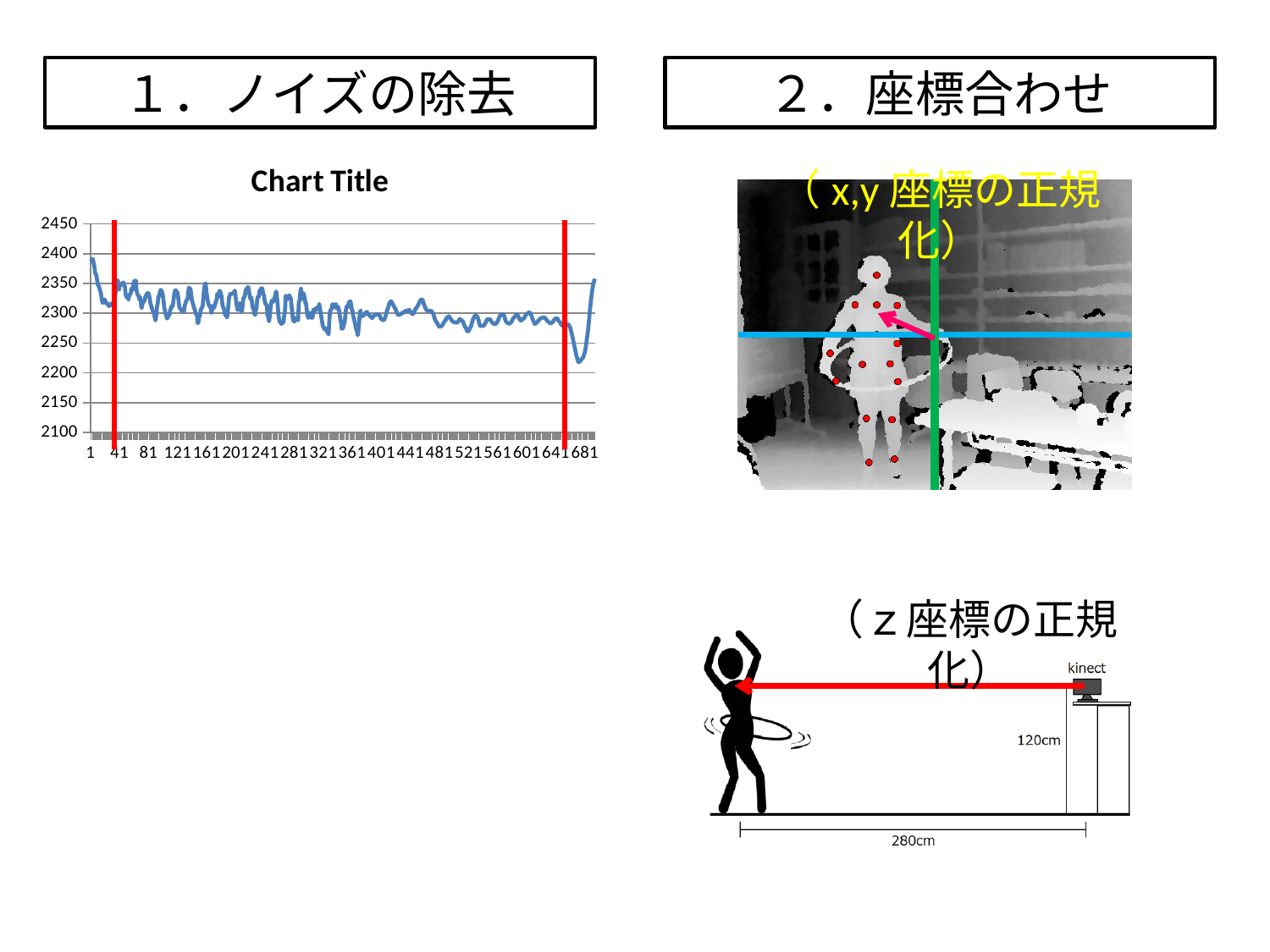
Is the value at x = 41 on the chart greater or less than 2300? greater What is the last label shown on the chart's horizontal axis? 681 What kind of chart is shown on the slide? line chart Is the lowest point of the line, near x = 661, greater or less than 2250? less Is the value at x = 641 on the chart greater or less than 2300? less What is the title of the chart on the slide? Chart Title What is the highest value shown on the chart's vertical axis? 2450 Between x = 1 and x = 641, do the values on the chart generally rise or fall? fall Which is larger on the chart: the value at x = 1 or the value at x = 641? the value at x = 1 What is the lowest value shown on the chart's vertical axis? 2100 How many red vertical lines are drawn on the chart? 2